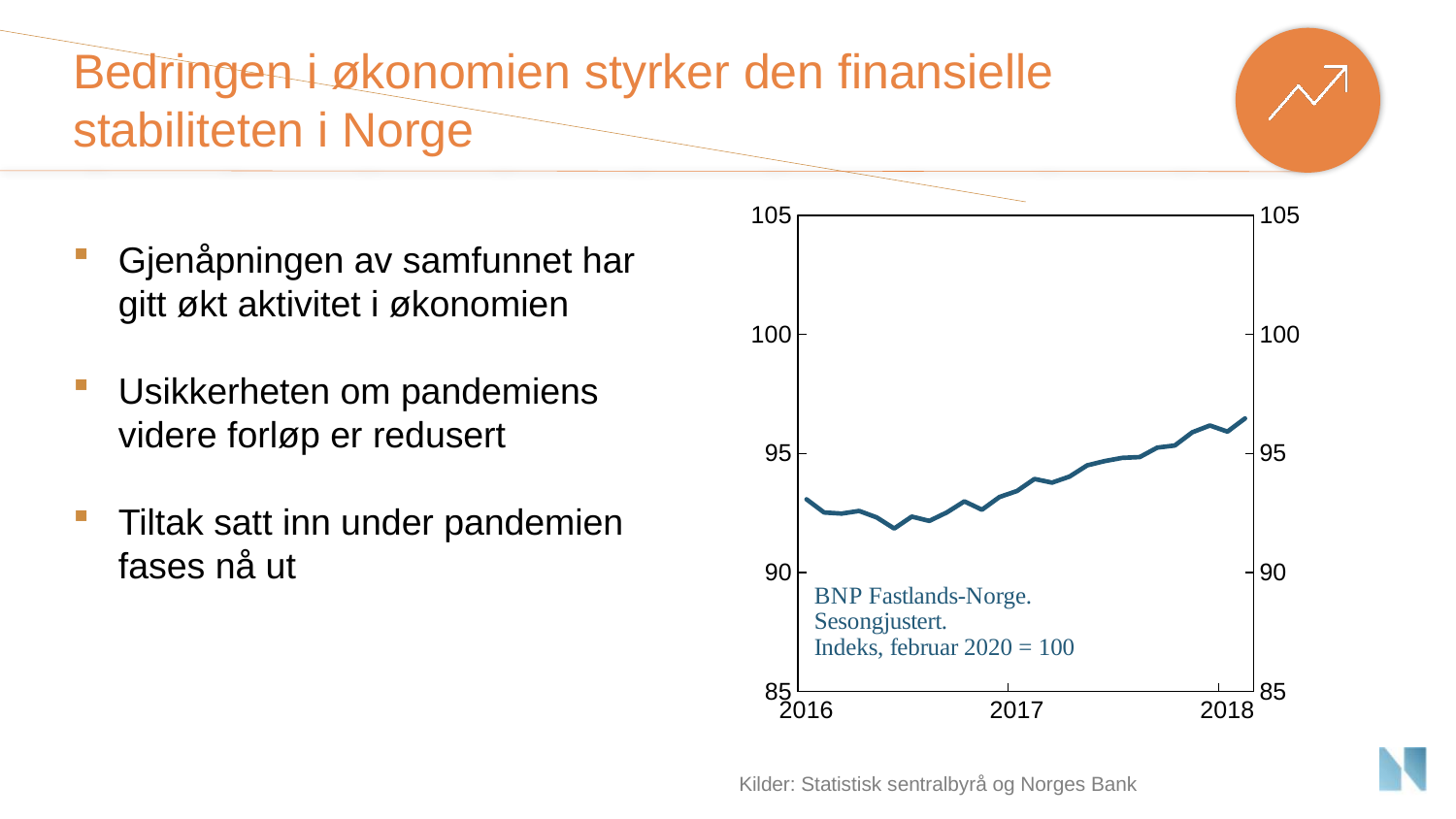
According to the text inside the chart, what base period is the index set to 100? februar 2020 Is the value of the line at the start of 2016 greater or less than 90? greater How many lines (series) are plotted in the chart? 1 Is the value of the line at the start of 2018 greater or less than 100? less Is the value of the line at the start of 2017 greater or less than 95? less What is the highest value shown on the chart's vertical axis? 105 What kind of chart is shown on the slide? line chart Is the value of the line at the start of 2018 higher or lower than at the start of 2016? higher Does the line in the chart generally rise or fall from 2016 to 2018? rise